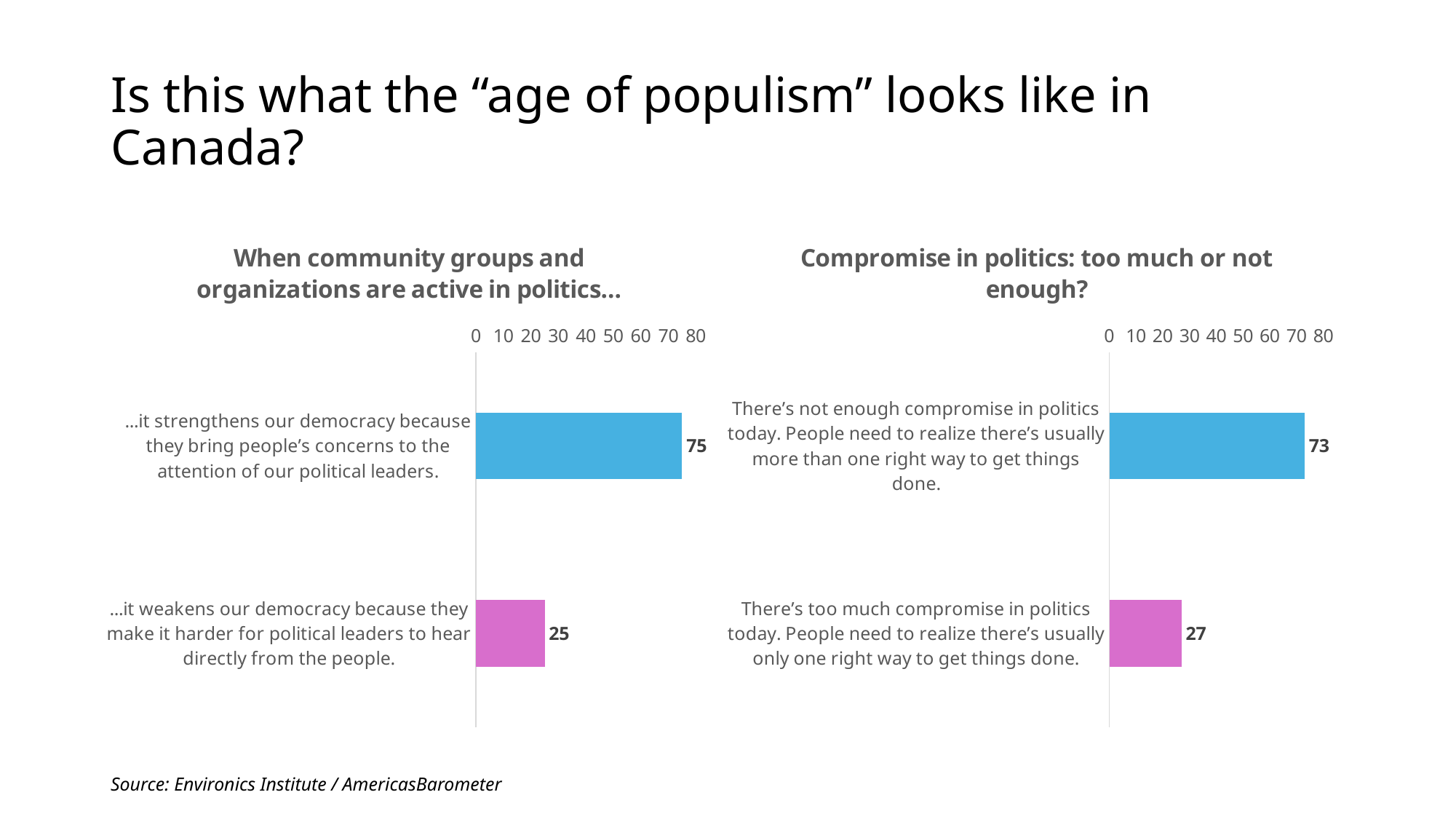
What kind of chart is the one titled "When community groups and organizations are active in politics..."? Bar chart How many categories are shown in the chart titled "Compromise in politics: too much or not enough?"? 2 In the chart titled "Compromise in politics: too much or not enough?", what is the value for "There's too much compromise in politics today"? 27 In the right chart, which category has the lowest value? There's too much compromise in politics today. People need to realize there's usually only one right way to get things done. In the left chart, what is the difference between the "strengthens our democracy" value and the "weakens our democracy" value? 50 In the left chart, which category has the highest value? ...it strengthens our democracy because they bring people's concerns to the attention of our political leaders. In the chart titled "When community groups and organizations are active in politics...", what is the value for "...it strengthens our democracy because they bring people's concerns to the attention of our political leaders."? 75 In the chart titled "Compromise in politics: too much or not enough?", what is the value for "There's not enough compromise in politics today"? 73 Which is larger: the "strengthens our democracy" value in the left chart or the "not enough compromise" value in the right chart? The "strengthens our democracy" value (75) What is the maximum value shown on the x axis of the right chart? 80 In the right chart, what is the difference between the "not enough compromise" value and the "too much compromise" value? 46 In the chart titled "When community groups and organizations are active in politics...", what is the value for "...it weakens our democracy because they make it harder for political leaders to hear directly from the people."? 25